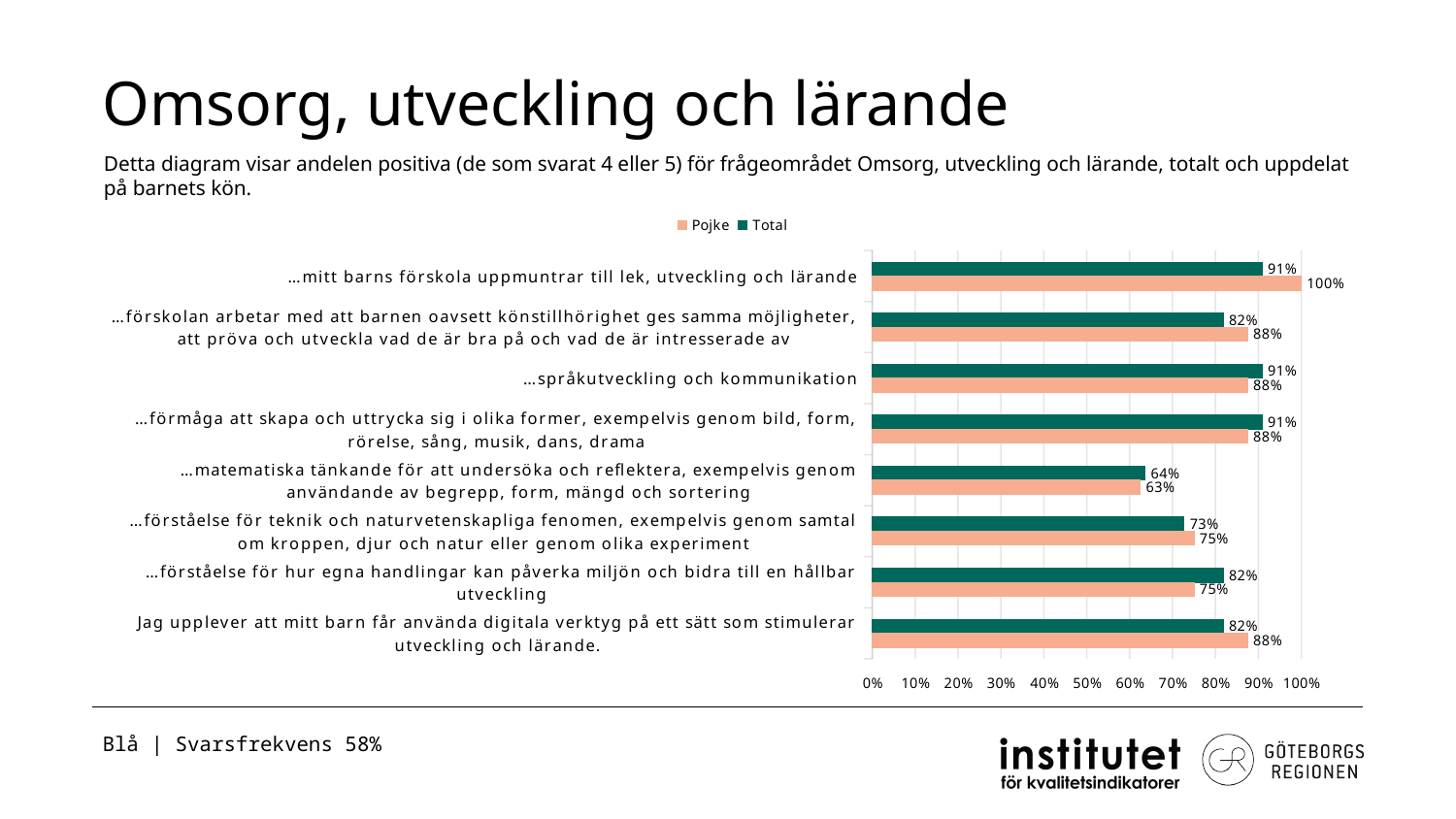
What kind of chart is shown on the slide? Bar chart How many categories are shown in the chart? 8 Which category has the lowest Total value? …matematiska tänkande för att undersöka och reflektera, exempelvis genom användande av begrepp, form, mängd och sortering What is the Pojke value for "…matematiska tänkande för att undersöka och reflektera, exempelvis genom användande av begrepp, form, mängd och sortering"? 63% What is the Total value for "…språkutveckling och kommunikation"? 91% How many series does the legend list? 2 Is the Total value for "…matematiska tänkande för att undersöka och reflektera, exempelvis genom användande av begrepp, form, mängd och sortering" greater or less than 70%? less For "Jag upplever att mitt barn får använda digitala verktyg på ett sätt som stimulerar utveckling och lärande.", which is larger, the Pojke value or the Total value? Pojke Which category has the highest Pojke value? …mitt barns förskola uppmuntrar till lek, utveckling och lärande What is the Total value for "…förståelse för teknik och naturvetenskapliga fenomen, exempelvis genom samtal om kroppen, djur och natur eller genom olika experiment"? 73% What is the difference between the Pojke and Total values for "…förståelse för hur egna handlingar kan påverka miljön och bidra till en hållbar utveckling"? 7 percentage points What is the Pojke value for "…mitt barns förskola uppmuntrar till lek, utveckling och lärande"? 100%